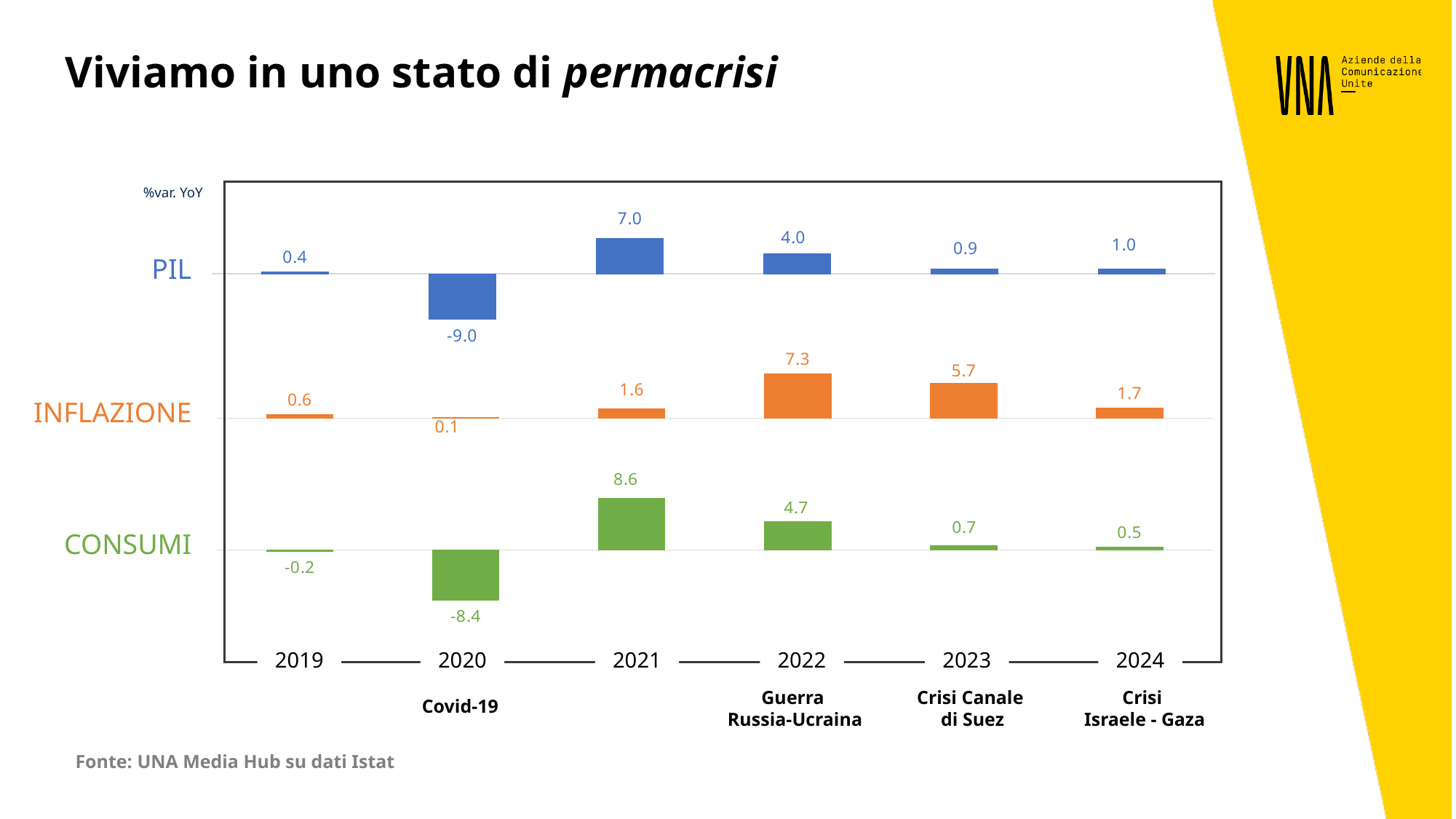
What is the difference between the INFLAZIONE values for 2022 and 2023? 1.6 What is the CONSUMI value for 2021? 8.6 What is the PIL value for 2024? 1.0 In which year is CONSUMI lowest? 2020 How many years are shown on the x axis? 6 How many series (PIL, INFLAZIONE, CONSUMI) does the chart show? 3 What kind of chart is this? Bar chart What is the INFLAZIONE value for 2022? 7.3 What is the PIL value for 2020? -9.0 In which year is INFLAZIONE highest? 2022 Which is larger, the CONSUMI value for 2022 or the PIL value for 2022? CONSUMI (4.7) In which year is PIL highest? 2021